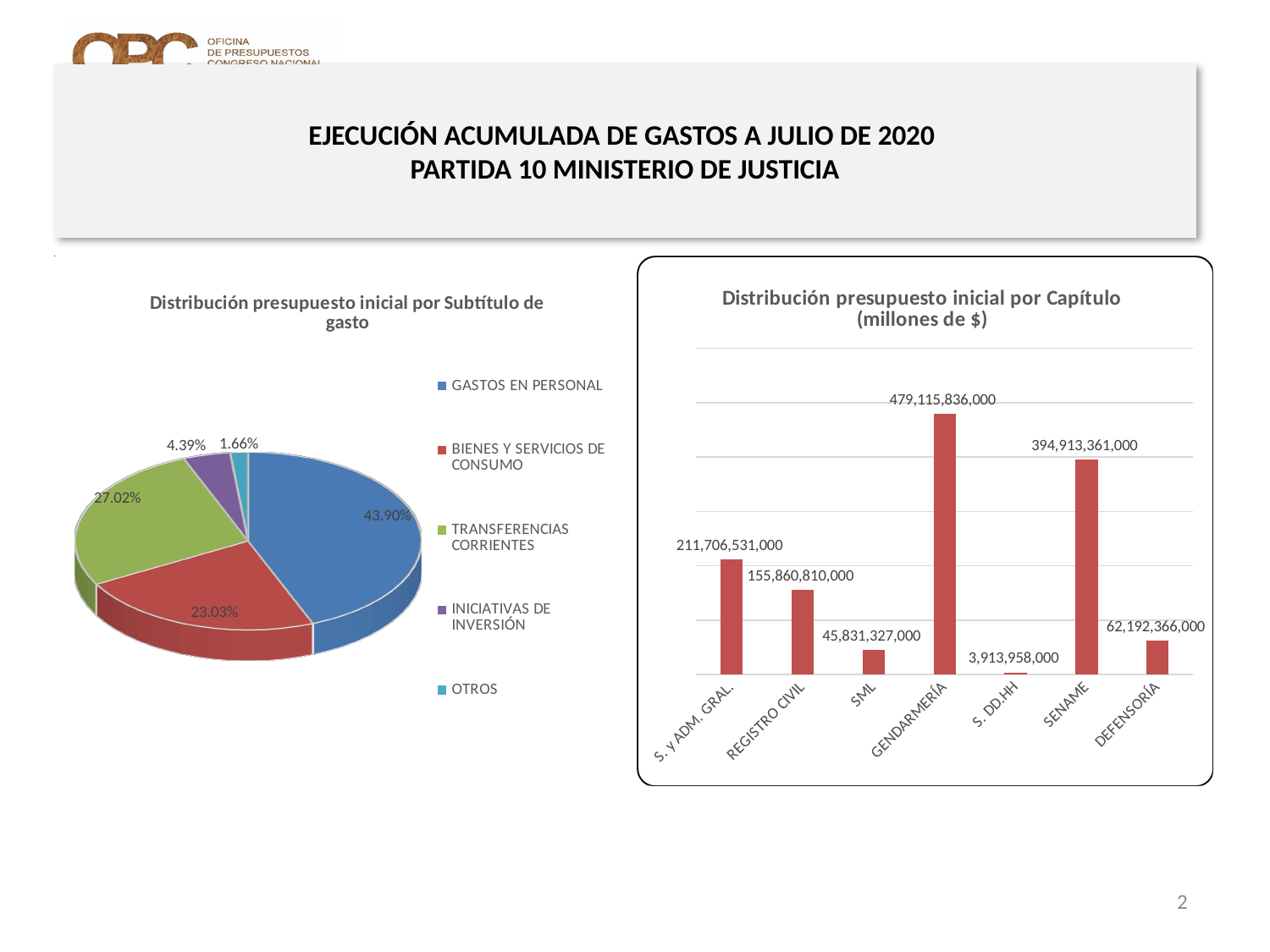
In the bar chart 'Distribución presupuesto inicial por Capítulo', what is the difference between GENDARMERÍA and SENAME? 84,202,475,000 What type of chart is 'Distribución presupuesto inicial por Capítulo'? Bar chart In the bar chart 'Distribución presupuesto inicial por Capítulo', which category has the lowest value? S. DD.HH In the bar chart 'Distribución presupuesto inicial por Capítulo', what is the value for GENDARMERÍA? 479,115,836,000 In the pie chart 'Distribución presupuesto inicial por Subtítulo de gasto', which category has the smallest share? OTROS In the pie chart 'Distribución presupuesto inicial por Subtítulo de gasto', what is the difference in percentage points between GASTOS EN PERSONAL and TRANSFERENCIAS CORRIENTES? 16.88% In the bar chart 'Distribución presupuesto inicial por Capítulo', what is the value for SML? 45,831,327,000 In the pie chart 'Distribución presupuesto inicial por Subtítulo de gasto', what share does GASTOS EN PERSONAL have? 43.90% In the pie chart 'Distribución presupuesto inicial por Subtítulo de gasto', how many categories does the legend list? 5 In the bar chart 'Distribución presupuesto inicial por Capítulo', which is larger, REGISTRO CIVIL or DEFENSORÍA? REGISTRO CIVIL In the bar chart 'Distribución presupuesto inicial por Capítulo', which category has the highest value? GENDARMERÍA In the pie chart 'Distribución presupuesto inicial por Subtítulo de gasto', what share does TRANSFERENCIAS CORRIENTES have? 27.02%